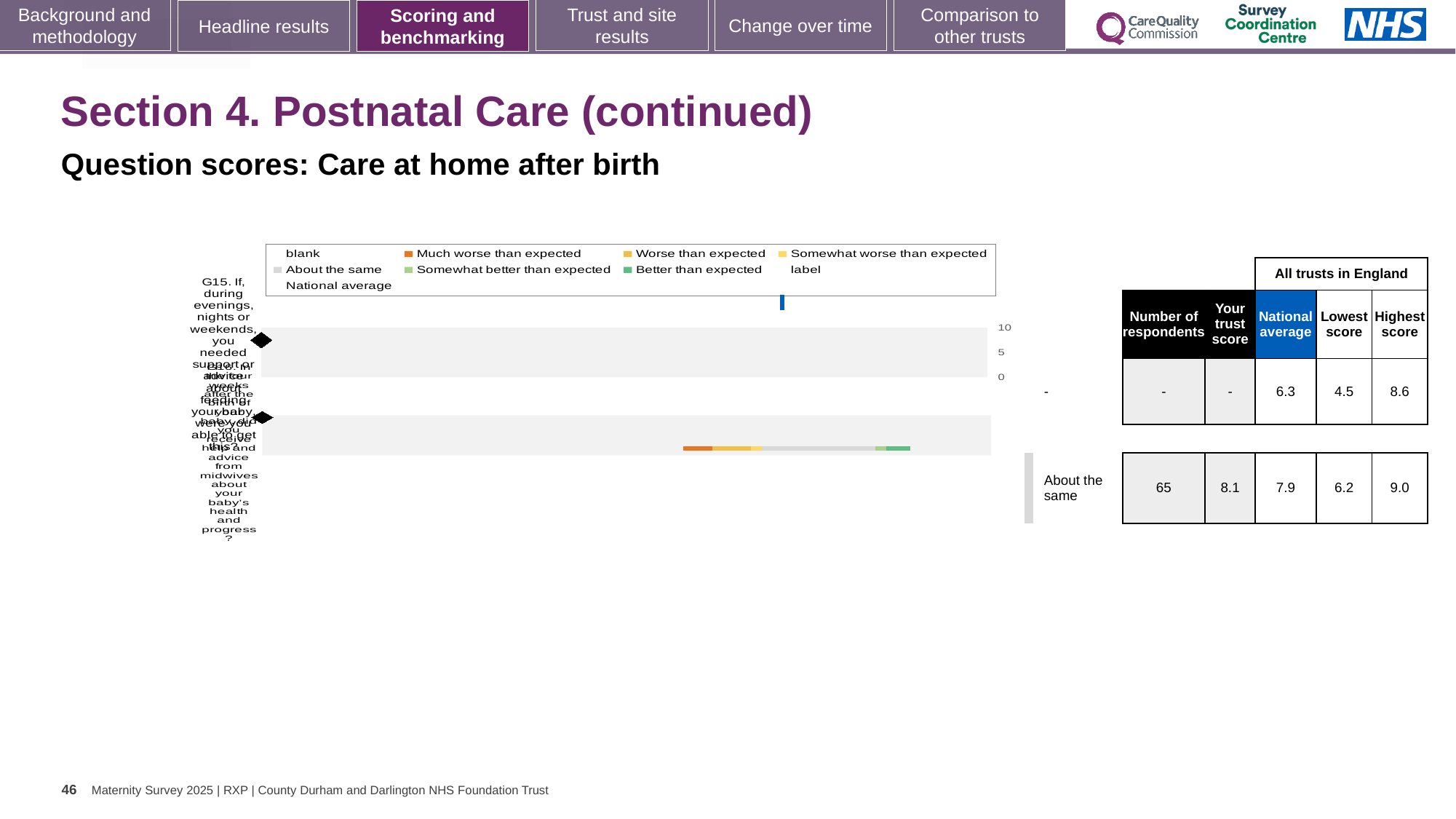
In the table beside the chart, how many respondents are listed for the row labelled 'About the same'? 65 How many question rows (bars) are plotted on the chart? 2 In the table beside the chart, what is the difference between the highest score (9.0) and the lowest score (6.2) for the 'About the same' row? 2.8 What kind of chart is shown on the slide? bar chart In the table beside the chart, is the trust score for 'About the same' (8.1) larger or smaller than the national average (7.9)? larger What colour does the legend use for 'Better than expected'? green What is the highest tick value shown on the chart's axis? 10 In the table beside the chart, what is the 'Your trust score' for the row labelled 'About the same'? 8.1 How many entries does the chart's legend list? 9 In the table beside the chart, what is the national average for the row labelled 'About the same'? 7.9 What colour does the legend use for 'Much worse than expected'? orange In the table beside the chart, what is the highest score for the first row (national average 6.3)? 8.6